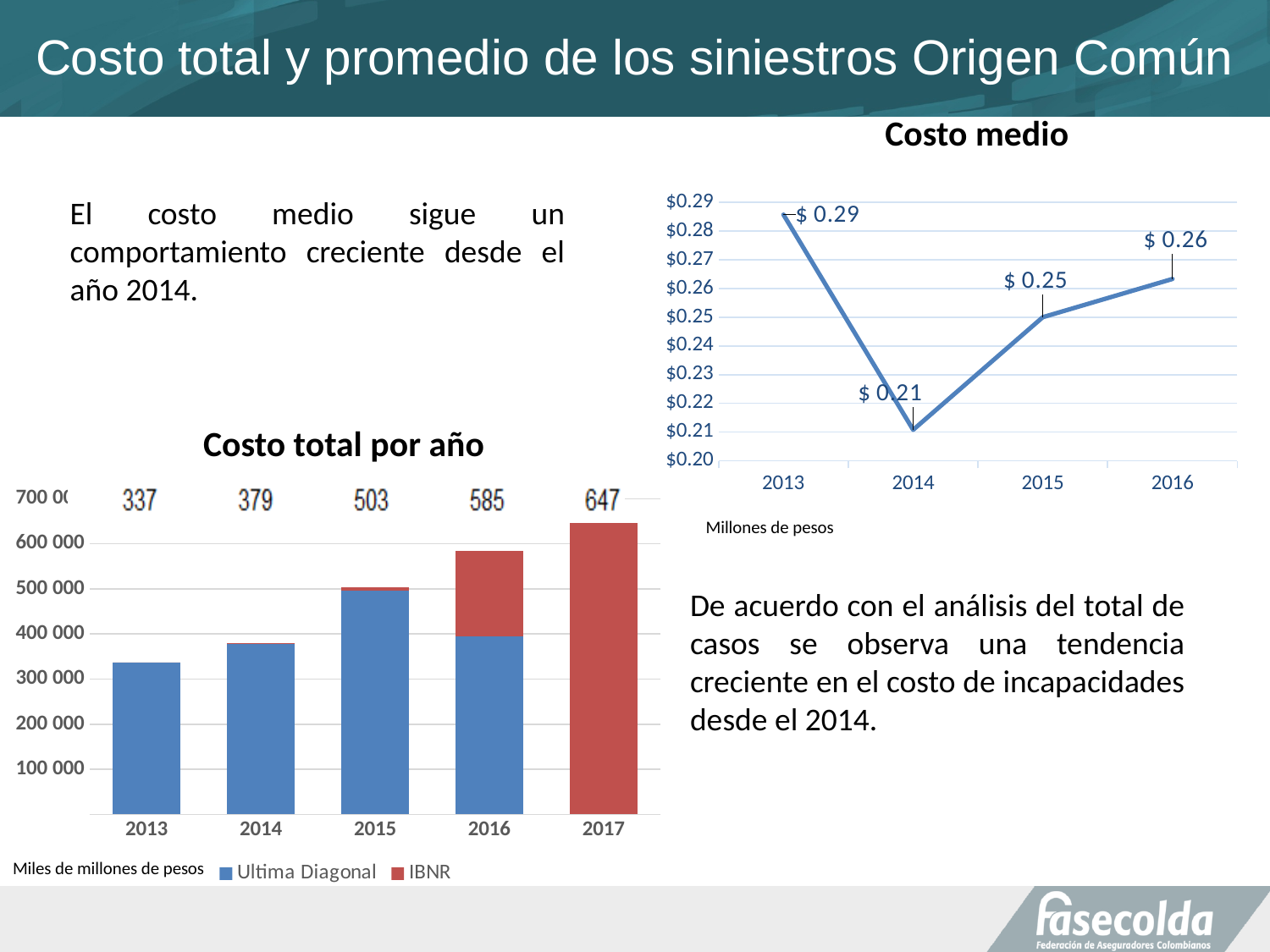
In the 'Costo medio' chart, what is the difference between the 2013 value and the 2014 value? $ 0.08 In the 'Costo medio' chart, do the values rise or fall from 2014 to 2016? rise What kind of chart is the 'Costo medio' chart? line chart How many series does the legend of the 'Costo total por año' chart list? 2 In the 'Costo total por año' chart, what is the total labelled for 2017? 647 In the 'Costo medio' chart, which year has the highest value? 2013 In the 'Costo medio' chart, which year has the lowest value? 2014 In the 'Costo total por año' chart, what is the total labelled for 2015? 503 In the 'Costo medio' chart, what is the value for 2014? $ 0.21 In the 'Costo medio' chart, what is the value for 2013? $ 0.29 In the 'Costo total por año' chart, what is the difference between the totals for 2016 and 2015? 82